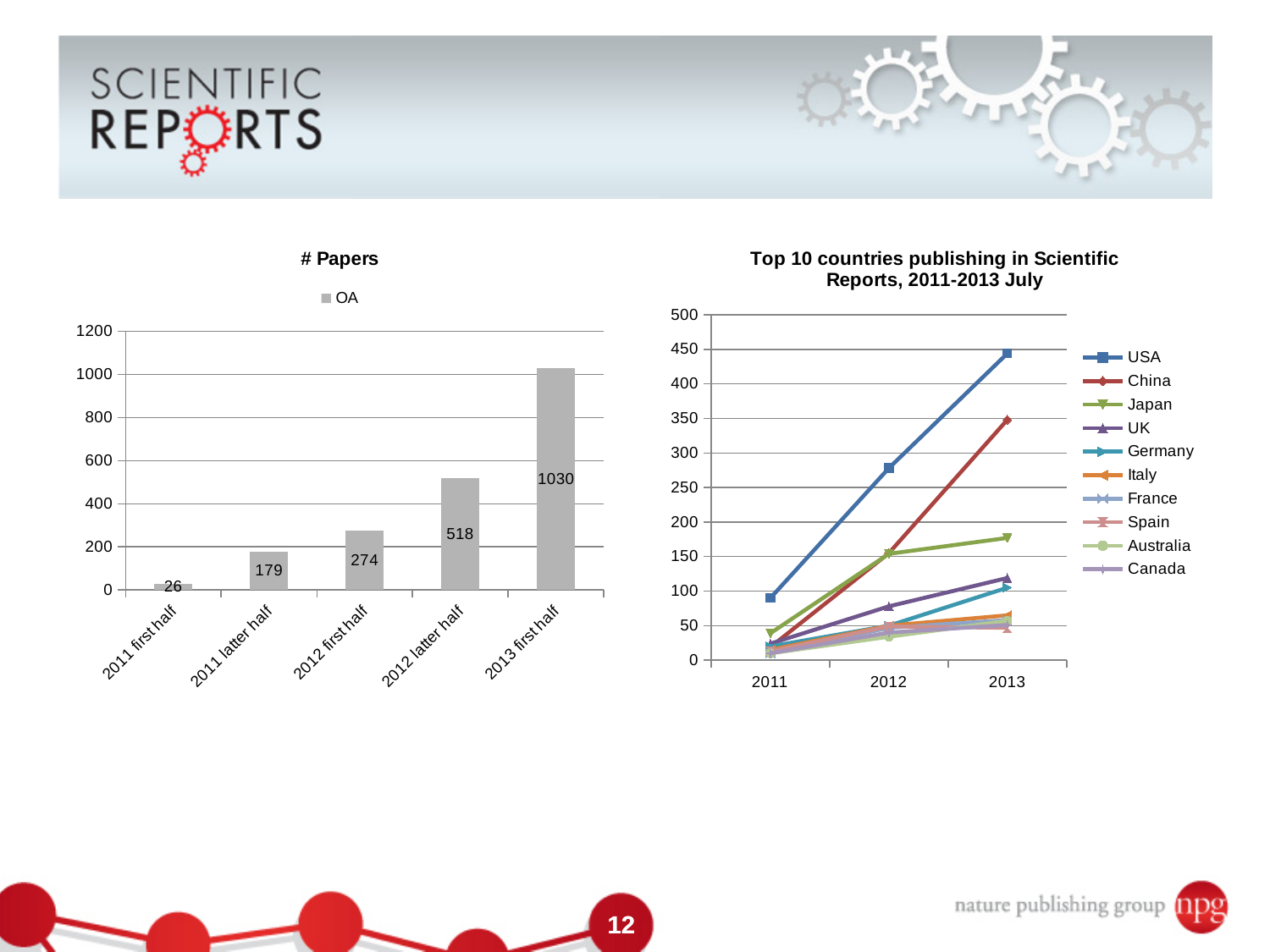
In the '# Papers' chart, how many papers are shown for 2013 first half? 1030 In the '# Papers' chart, what is the difference between 2012 latter half and 2012 first half? 244 What kind of chart is the 'Top 10 countries publishing in Scientific Reports' chart? line chart What kind of chart is the '# Papers' chart? bar chart In the 'Top 10 countries publishing in Scientific Reports' chart, is the value for USA in 2013 greater or less than 400? greater In the '# Papers' chart, what is the value for 2011 latter half? 179 In the 'Top 10 countries publishing in Scientific Reports' chart, which is larger in 2013, China or Japan? China In the '# Papers' chart, do the values rise or fall from 2011 first half to 2013 first half? rise In the 'Top 10 countries publishing in Scientific Reports' chart, which country has the highest value in 2013? USA In the 'Top 10 countries publishing in Scientific Reports' chart, how many countries does the legend list? 10 In the '# Papers' chart, which period has the lowest number of papers? 2011 first half In the '# Papers' chart, how many periods are shown on the x axis? 5